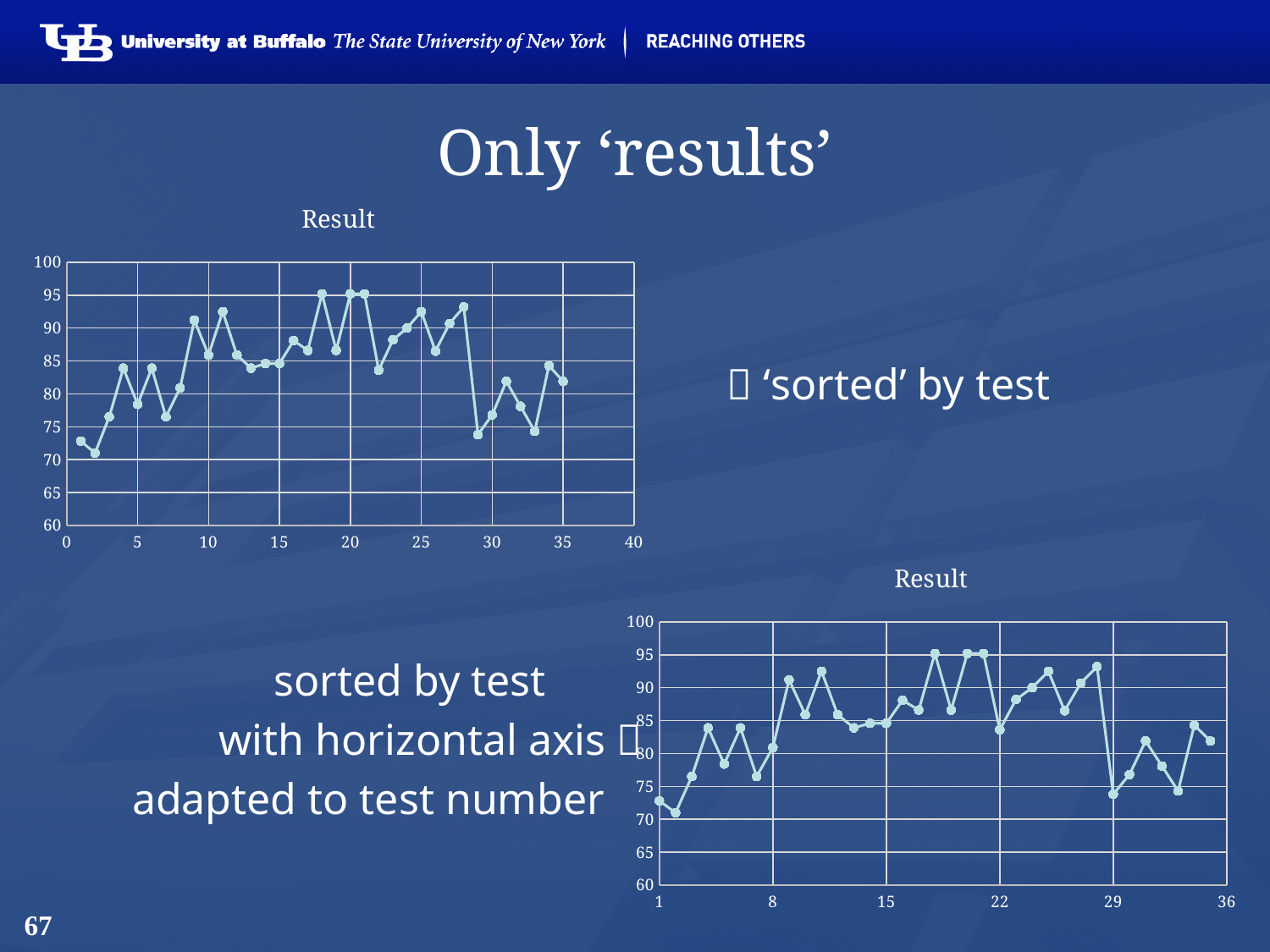
In the top-left chart, is the value at x = 9 greater or less than 85? greater In the top-left chart, is the value at x = 29 greater or less than 80? less What is the highest value shown on the horizontal axis of the bottom-right chart? 36 What kind of chart is the top-left chart on the slide? line chart What is the title of the top-left chart? Result In the top-left chart, which has the larger value: x = 9 or x = 2? x = 9 How many charts are shown on the slide? 2 In the bottom-right chart, which has the larger value: test 22 or test 29? test 22 In the top-left chart, is the value at x = 20 greater or less than 90? greater What kind of chart is the bottom-right chart on the slide? line chart